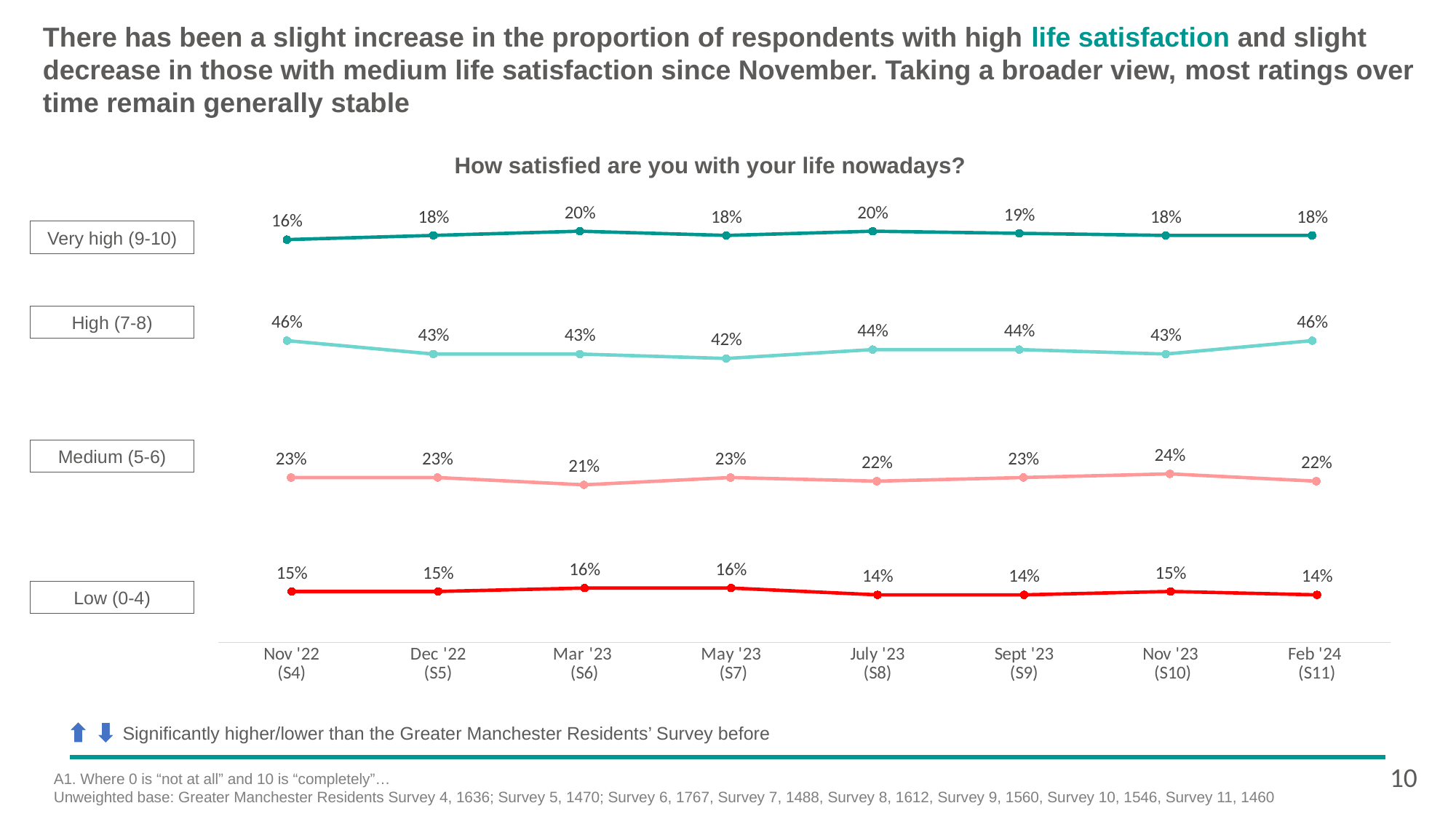
What is the title of the chart? How satisfied are you with your life nowadays? What is the difference between the High (7-8) value and the Very high (9-10) value in Nov '22 (S4)? 30% How many survey waves are shown on the x axis? 8 What is the value for High (7-8) in May '23 (S7)? 42% What is the value for Medium (5-6) in Nov '23 (S10)? 24% In which survey wave is the Medium (5-6) series at its highest? Nov '23 (S10) Which is larger in Feb '24 (S11): the Medium (5-6) value or the Low (0-4) value? Medium (5-6) In which survey wave is the High (7-8) series at its lowest? May '23 (S7) How many series (satisfaction bands) are plotted on the chart? 4 What is the value for Very high (9-10) in Feb '24 (S11)? 18% What is the value for Low (0-4) in Mar '23 (S6)? 16% What type of chart is shown on the slide? Line chart